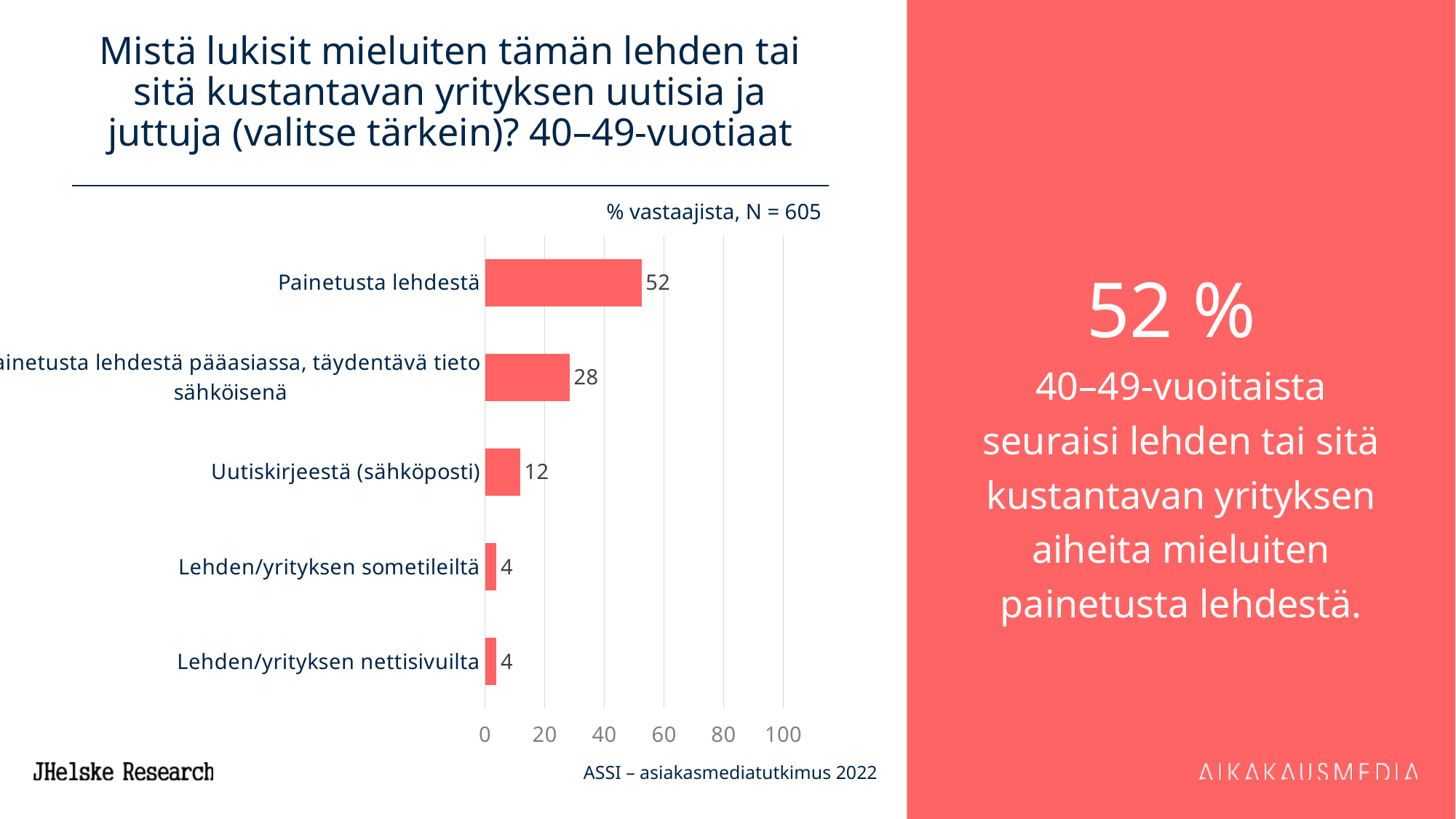
What is the value for Uutiskirjeestä (sähköposti)? 12 How many categories are shown in the chart? 5 What kind of chart is shown on the slide? bar chart What is the difference between the values for Painetusta lehdestä and Painetusta lehdestä pääasiassa, täydentävä tieto sähköisenä? 24 What is the value for Painetusta lehdestä? 52 What is the value for Painetusta lehdestä pääasiassa, täydentävä tieto sähköisenä? 28 What is the difference between the values for Painetusta lehdestä and Uutiskirjeestä (sähköposti)? 40 Which is larger, the value for Uutiskirjeestä (sähköposti) or the value for Lehden/yrityksen nettisivuilta? Uutiskirjeestä (sähköposti) Is the value for Painetusta lehdestä greater or less than 40? greater What is the sample size (N) stated above the chart? 605 Which category has the highest value? Painetusta lehdestä What is the value for Lehden/yrityksen sometileiltä? 4